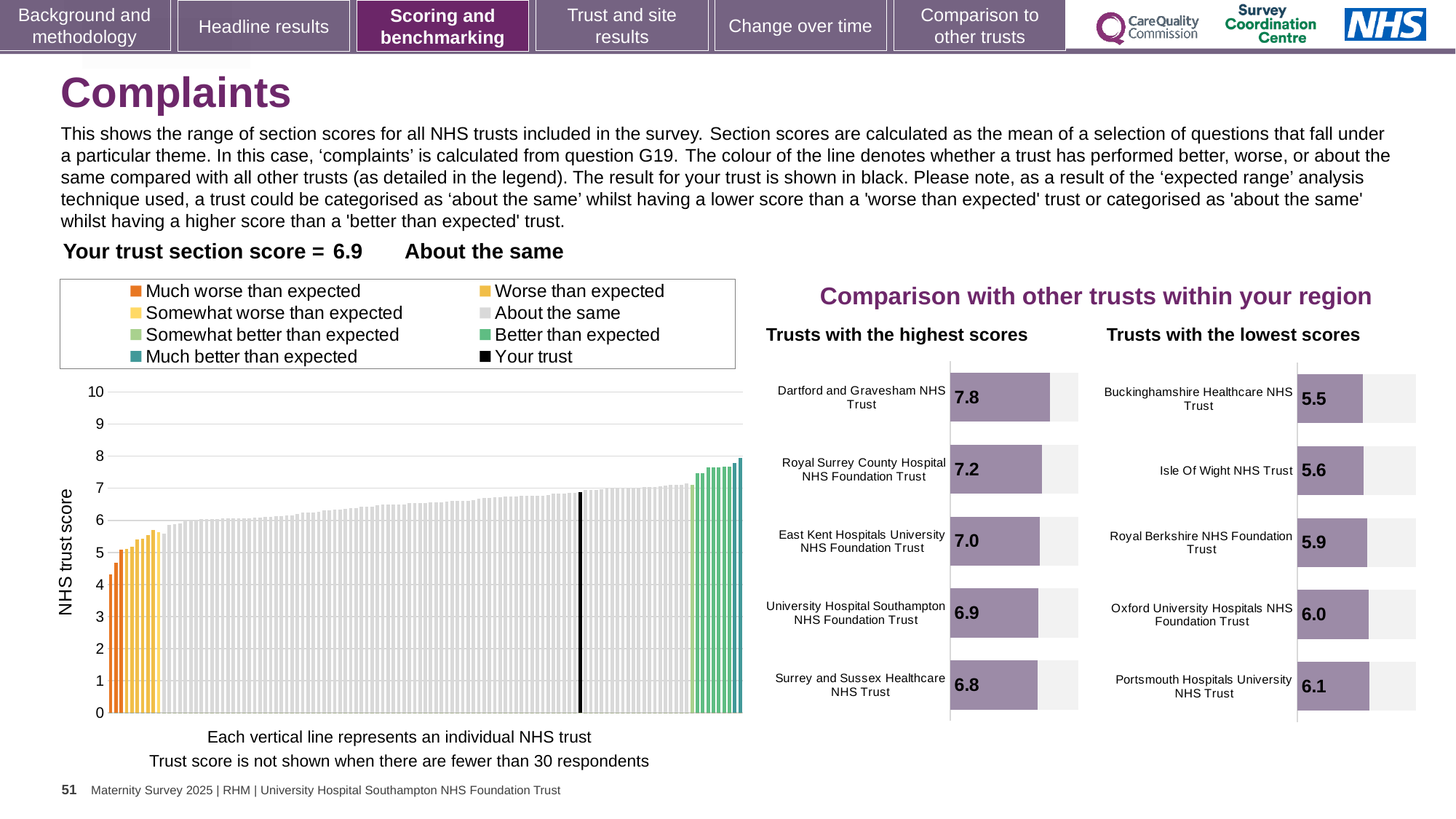
In the 'Trusts with the lowest scores' chart, which has the larger score: Isle Of Wight NHS Trust or Oxford University Hospitals NHS Foundation Trust? Oxford University Hospitals NHS Foundation Trust In the 'Trusts with the highest scores' chart, what is the difference between the scores of Dartford and Gravesham NHS Trust and Surrey and Sussex Healthcare NHS Trust? 1.0 In the 'Trusts with the lowest scores' chart, which trust has the highest score? Portsmouth Hospitals University NHS Trust In the NHS trust score chart on the left, is the value of the tallest bar greater or less than 7? greater In the 'Trusts with the highest scores' chart, how many trusts are listed? 5 In the 'Trusts with the lowest scores' chart, which trust has the lowest score? Buckinghamshire Healthcare NHS Trust In the 'Trusts with the highest scores' chart, which trust has the lowest score shown? Surrey and Sussex Healthcare NHS Trust In the 'Trusts with the lowest scores' chart, what is the score for Royal Berkshire NHS Foundation Trust? 5.9 In the 'Trusts with the lowest scores' chart, what is the difference between the scores of Portsmouth Hospitals University NHS Trust and Buckinghamshire Healthcare NHS Trust? 0.6 In the 'Trusts with the highest scores' chart, what is the score for Dartford and Gravesham NHS Trust? 7.8 In the NHS trust score chart on the left, what is the section score for your trust? 6.9 How many entries does the legend of the NHS trust score chart on the left list? 8